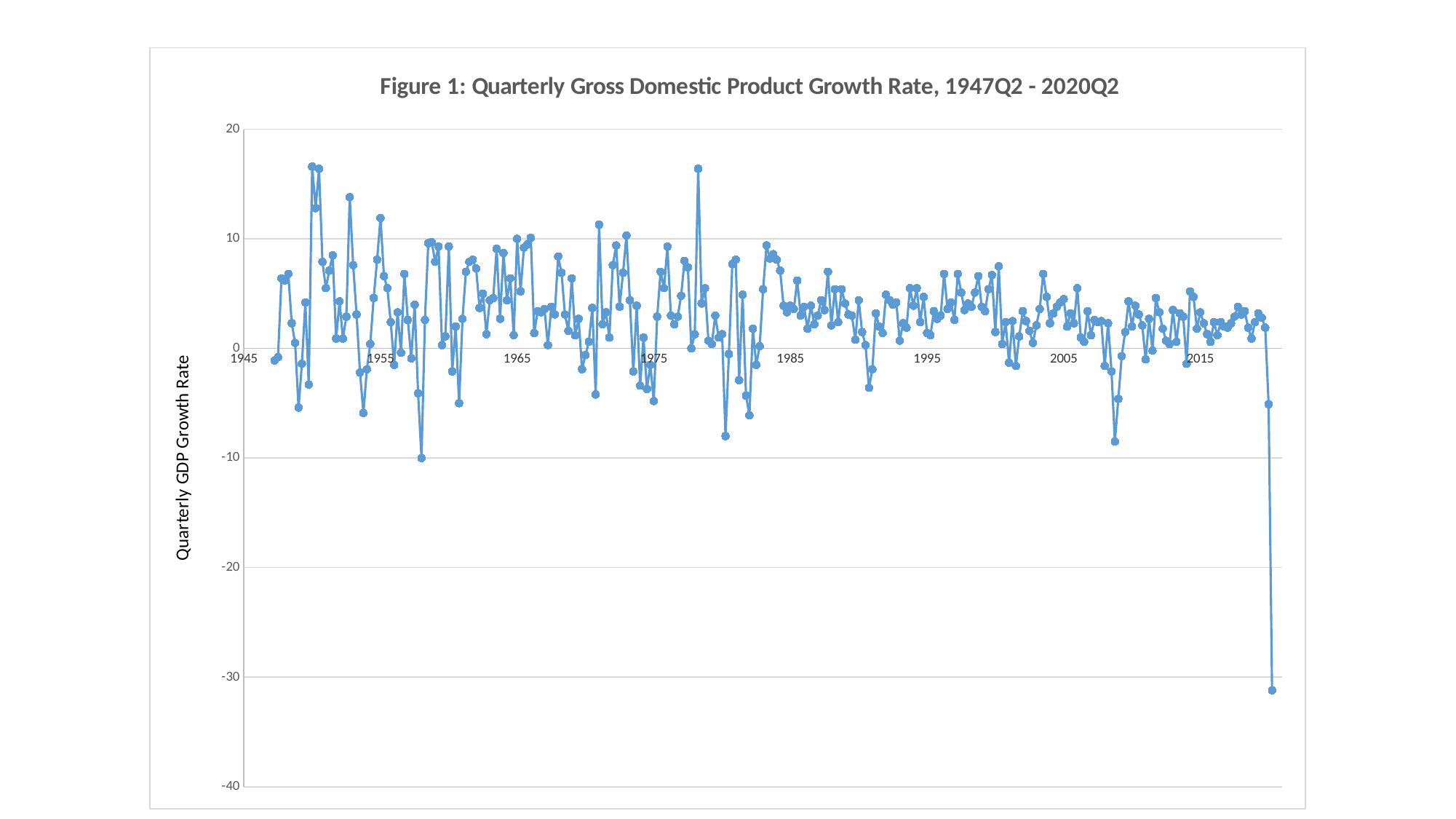
What is the title of the chart? Figure 1: Quarterly Gross Domestic Product Growth Rate, 1947Q2 - 2020Q2 Is the highest peak in the line around 1950 greater or less than 10? greater Is the trough in the line around 2008-2009 greater or less than -10? greater How many data series are plotted on the chart? 1 Is the lowest value on the chart, at the far right end of the line, greater or less than -20? less Does the line rise or fall sharply at its final data point compared with the point before it? fall What kind of chart is shown on the slide? line chart What is the lowest value shown on the vertical axis of the chart? -40 In which year does the lowest value on the chart occur? 2020 What is the label on the vertical axis of the chart? Quarterly GDP Growth Rate